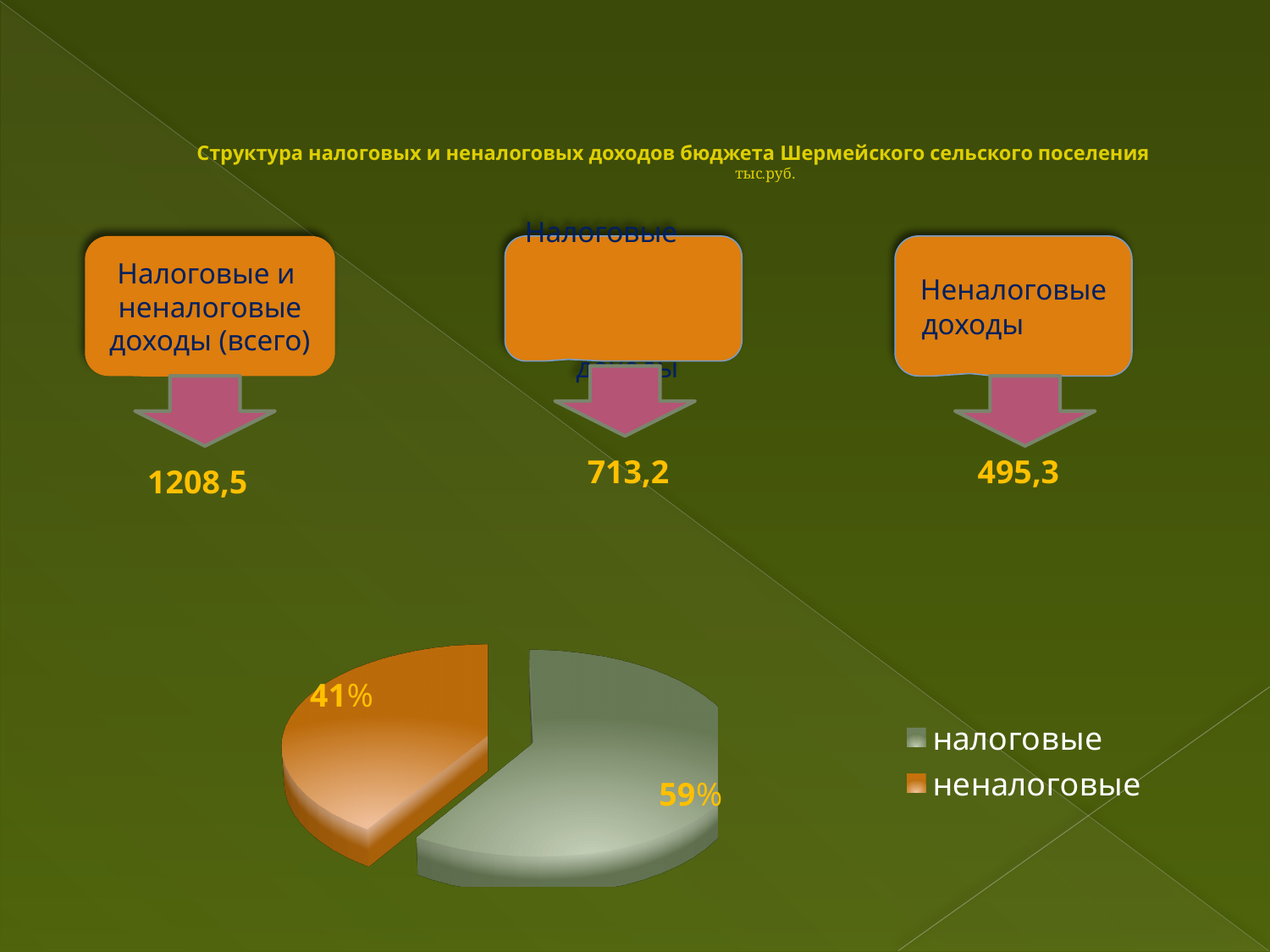
What colour is the "неналоговые" slice in the pie chart? orange Which is larger in the pie chart, "налоговые" or "неналоговые"? налоговые By how many percentage points does the "налоговые" share exceed the "неналоговые" share? 18 Which slice of the pie chart is the largest? налоговые How many slices does the pie chart have? 2 What kind of chart is shown on the slide? pie chart Where is the legend positioned relative to the pie chart? to the right How many entries does the legend of the pie chart list? 2 Which slice of the pie chart is the smallest? неналоговые What share of the pie does the "налоговые" slice represent? 59% Is the share of the "неналоговые" slice greater or less than 50%? less What share of the pie does the "неналоговые" slice represent? 41%